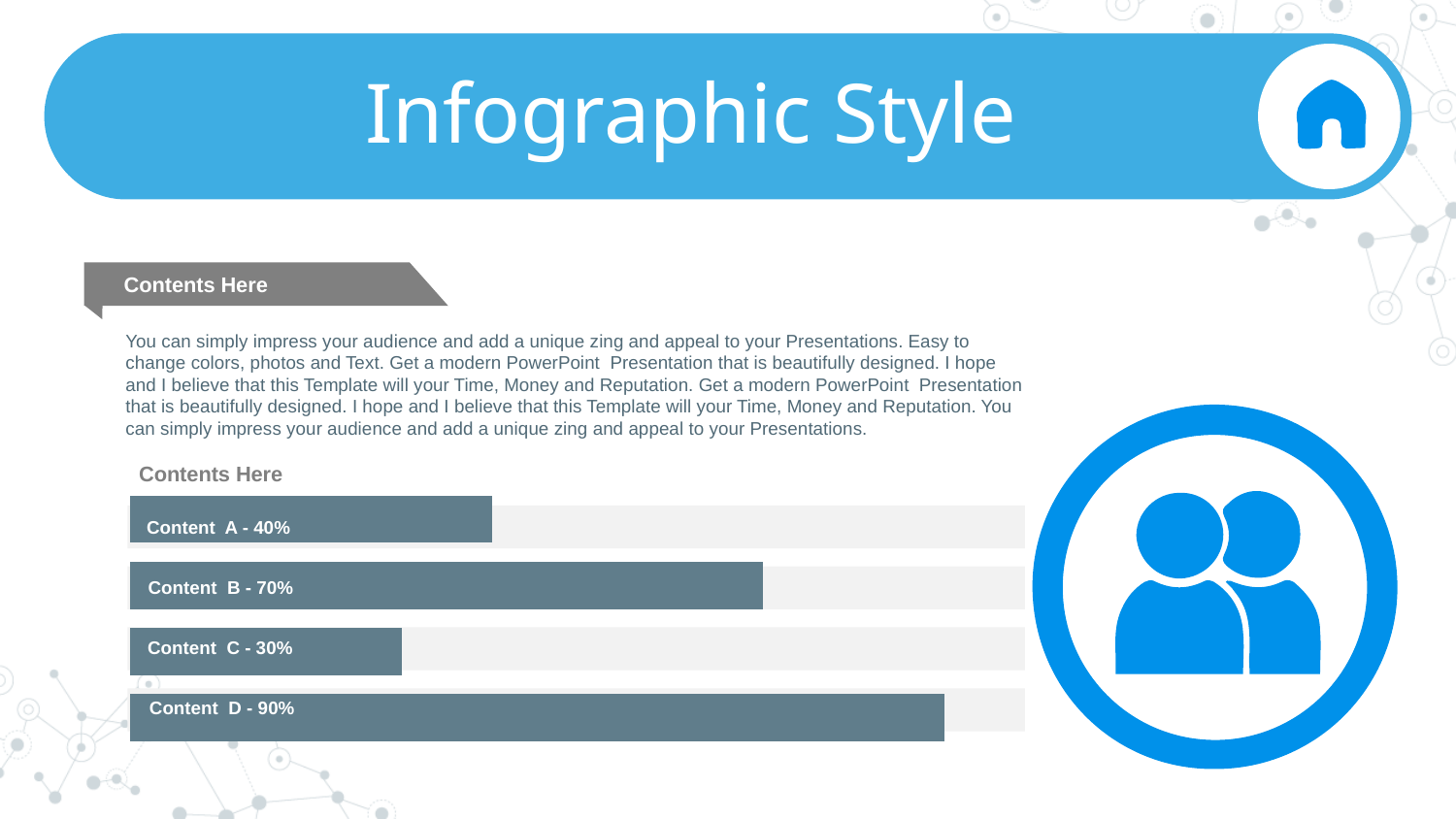
Which is larger, the value for Content B or the value for Content A? Content B Which category has the highest value? Content D What is the difference between the values for Content B and Content C? 40% What is the value for Content D? 90% What kind of chart is shown on the slide? bar chart What is the value for Content C? 30% How many categories are shown in the bar chart? 4 What is the heading shown directly above the bar chart? Contents Here Which category has the lowest value? Content C What is the difference between the values for Content D and Content A? 50% What is the value for Content B? 70% What is the value for Content A? 40%